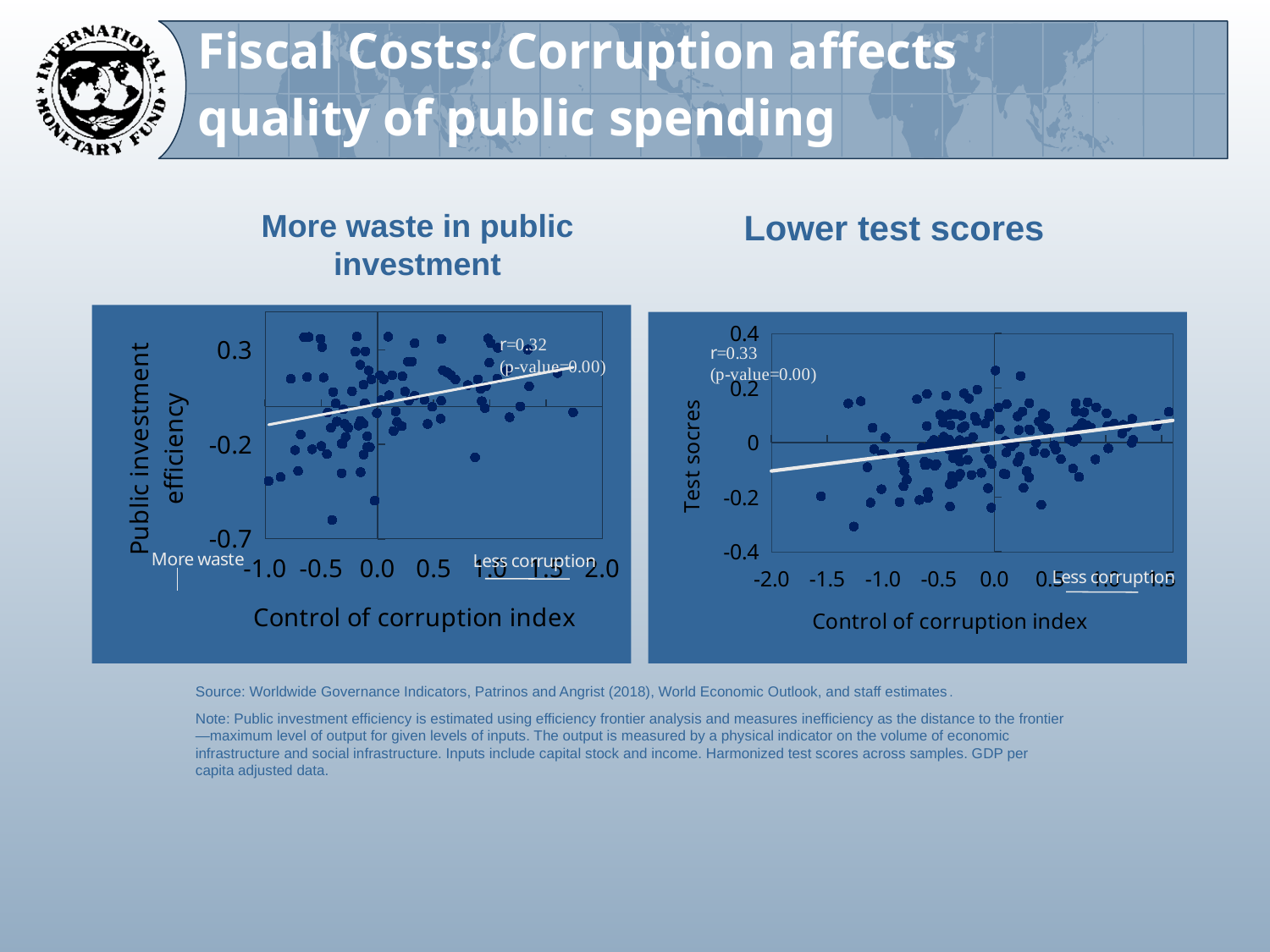
What is the x-axis label of the 'Lower test scores' chart? Control of corruption index What correlation coefficient (r) is printed on the 'More waste in public investment' chart? r=0.32 What kind of chart is the 'More waste in public investment' chart? scatter plot What kind of chart is the 'Lower test scores' chart? scatter plot What is the y-axis label of the 'More waste in public investment' chart? Public investment efficiency Which chart shows the larger correlation coefficient, 'More waste in public investment' or 'Lower test scores'? Lower test scores What p-value is printed on the 'Lower test scores' chart? p-value=0.00 In the 'More waste in public investment' chart, does the fitted line rise or fall as the control of corruption index increases? rise In the 'Lower test scores' chart, does the fitted line rise or fall as the control of corruption index increases? rise What correlation coefficient (r) is printed on the 'Lower test scores' chart? r=0.33